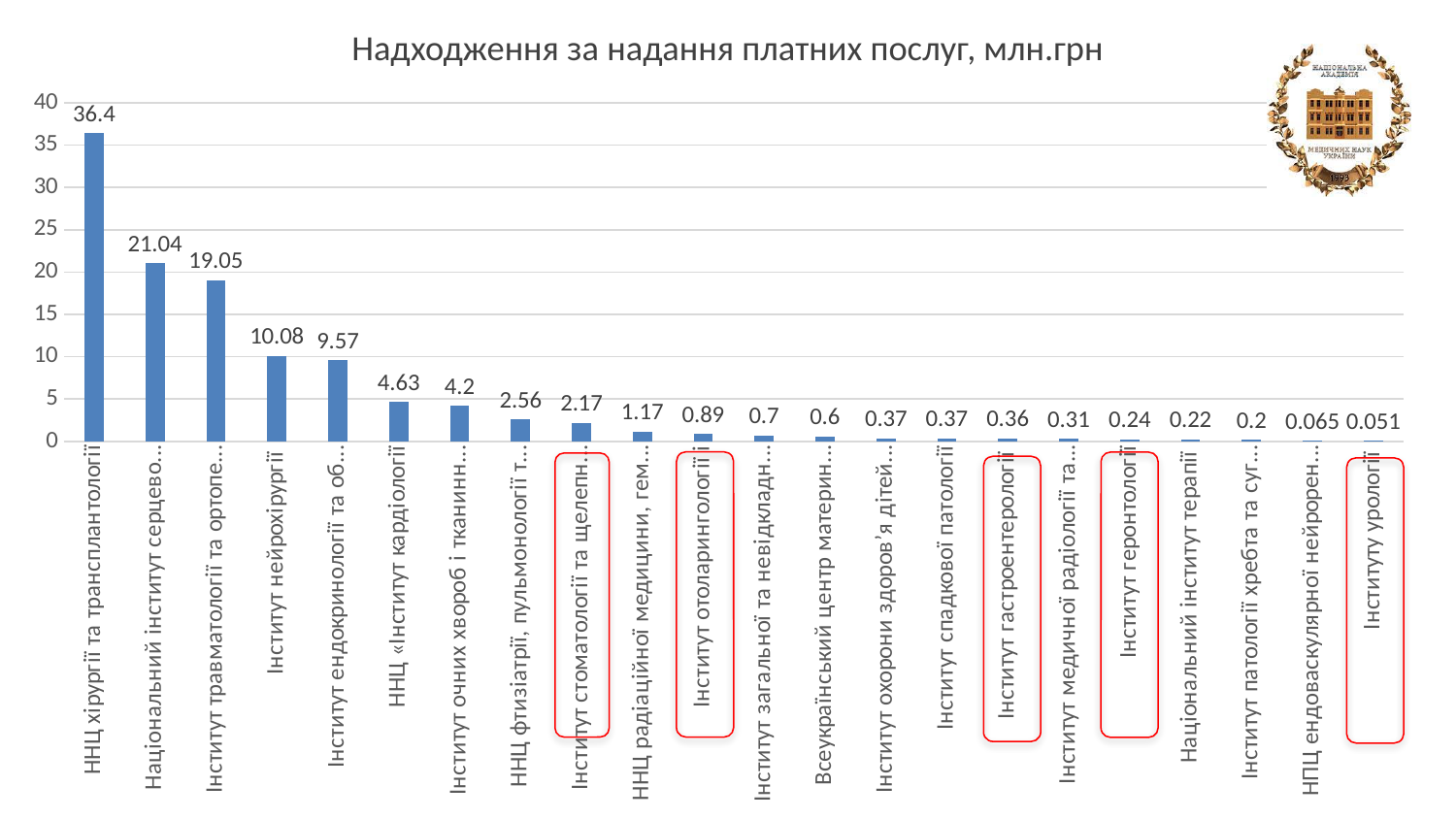
What is the value for Інститут отоларингології? 0.89 What is the title of the chart? Надходження за надання платних послуг, млн.грн What kind of chart is shown on the slide? bar chart How many categories are shown in the chart? 22 Which category has the highest value? ННЦ хірургії та трансплантології What is the difference between the values for ННЦ хірургії та трансплантології and Інститут нейрохірургії? 26.32 What is the value for Інститут гастроентерології? 0.36 Which is larger: the value for Інститут спадкової патології or the value for Національний інститут терапії? Інститут спадкової патології What is the value for Інститут геронтології? 0.24 Which category has the lowest value? Інституту урології Is the value for Інститут нейрохірургії greater or less than 5? greater What is the value for Інститут нейрохірургії? 10.08